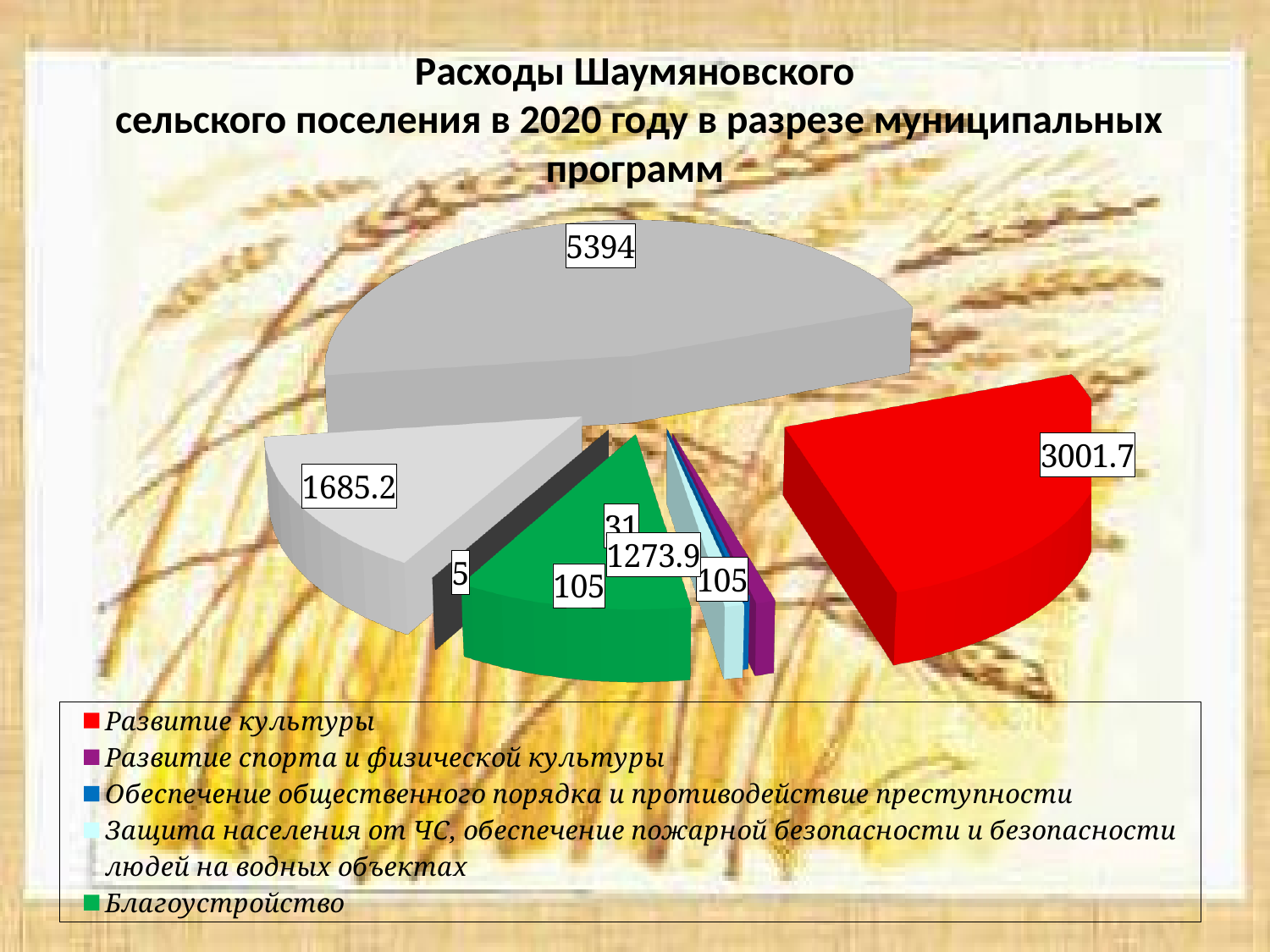
What is the value shown on the largest slice of the pie? 5394 Which colour represents Развитие культуры in the legend? red Which is larger: the value for Развитие культуры or the value for Благоустройство? Развитие культуры How many entries does the legend list? 5 How many data labels are shown on the pie chart? 8 What type of chart is shown on the slide? pie chart What is the value of the red slice (Развитие культуры)? 3001.7 What is the difference between the value for Развитие культуры (3001.7) and the value for Благоустройство (1273.9)? 1727.8 What is the smallest value labelled on the pie chart? 5 What is the value of the green slice (Благоустройство)? 1273.9 What is the difference between the largest slice (5394) and the red slice (3001.7)? 2392.3 Which is larger: the slice labelled 3001.7 or the slice labelled 1685.2? 3001.7